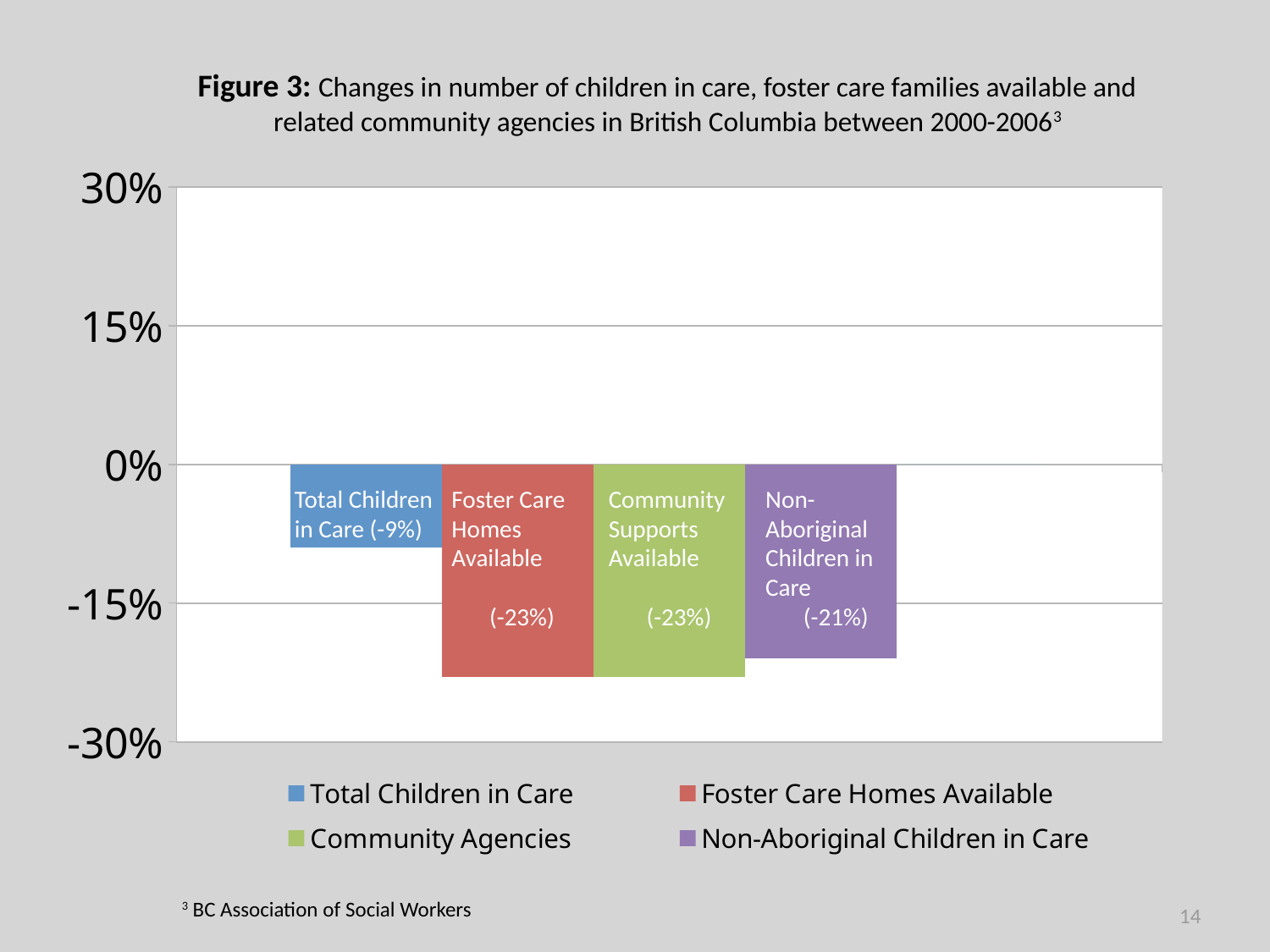
What is the difference between the values for Total Children in Care and Non-Aboriginal Children in Care? 12 percentage points What is the value shown for Community Supports Available? -23% What kind of chart is shown on the slide? Bar chart What is the value shown for Total Children in Care? -9% What is the value shown for Foster Care Homes Available? -23% Is the value for Non-Aboriginal Children in Care greater or less than -15%? less Which is larger, the value for Total Children in Care or the value for Foster Care Homes Available? Total Children in Care Is the value for Total Children in Care greater or less than -15%? greater What is the value shown for Non-Aboriginal Children in Care? -21% How many series does the legend list? 4 How many bars are plotted on the chart? 4 Which category has the highest value (the smallest decrease)? Total Children in Care